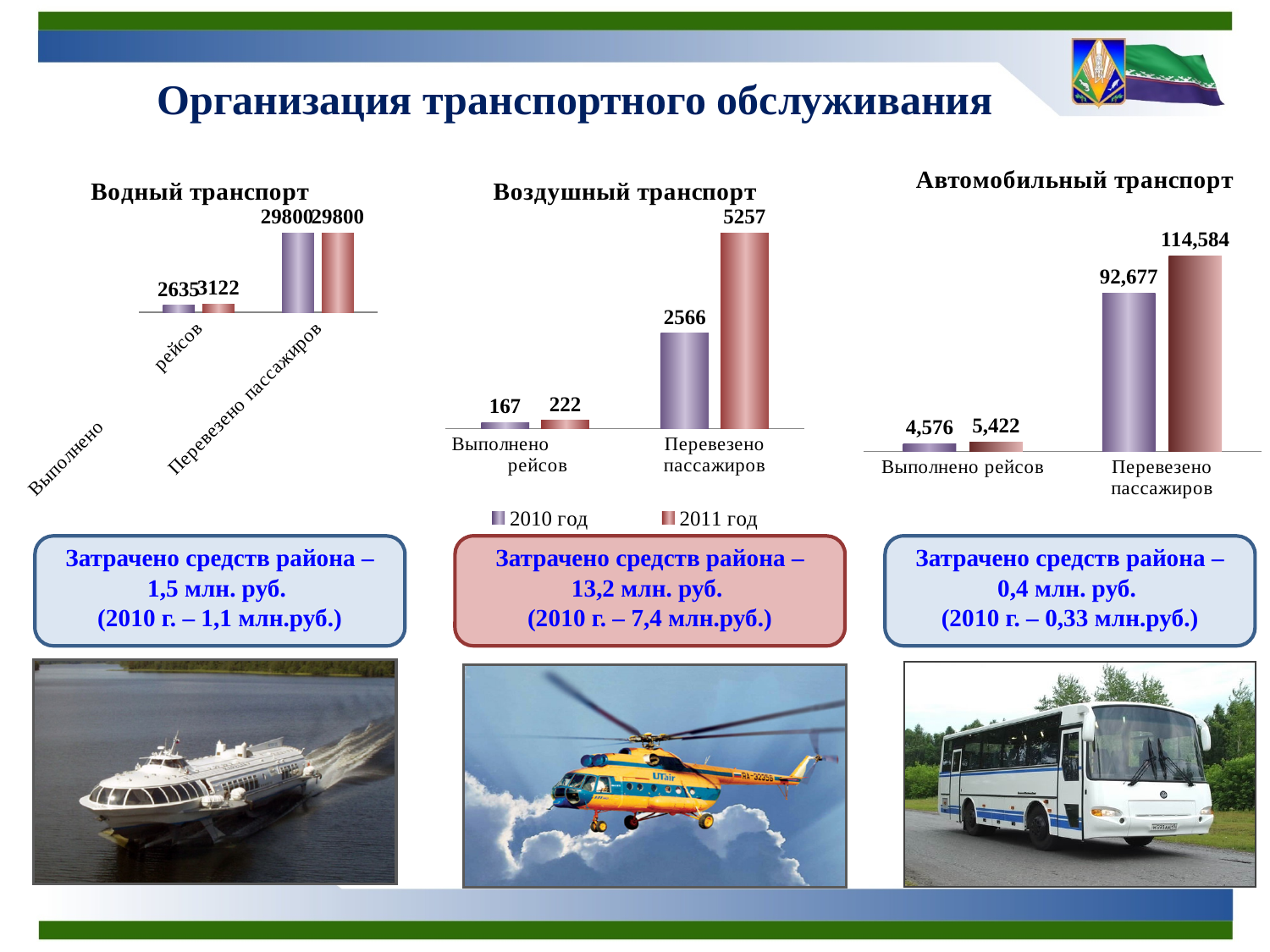
How many categories are shown on the x axis of the Автомобильный транспорт chart? 2 In the Воздушный транспорт chart, what is the value for Перевезено пассажиров in 2011 год? 5257 In the Воздушный транспорт chart, which is larger for Выполнено рейсов: 2010 год or 2011 год? 2011 год In the Автомобильный транспорт chart, which category has the highest value? Перевезено пассажиров In the Автомобильный транспорт chart, what is the value for Выполнено рейсов in 2010 год? 4,576 In the Водный транспорт chart, what is the value for Перевезено пассажиров in 2011 год? 29800 In the Автомобильный транспорт chart, what is the value for Перевезено пассажиров in 2011 год? 114,584 In the Воздушный транспорт chart, what is the difference between the 2011 год and 2010 год values for Перевезено пассажиров? 2691 In the Воздушный транспорт chart, what is the value for Выполнено рейсов in 2010 год? 167 How many series does the legend under the Воздушный транспорт chart list? 2 In the Автомобильный транспорт chart, what is the difference between the 2011 год and 2010 год values for Перевезено пассажиров? 21,907 What kind of chart is the Воздушный транспорт chart? Bar chart